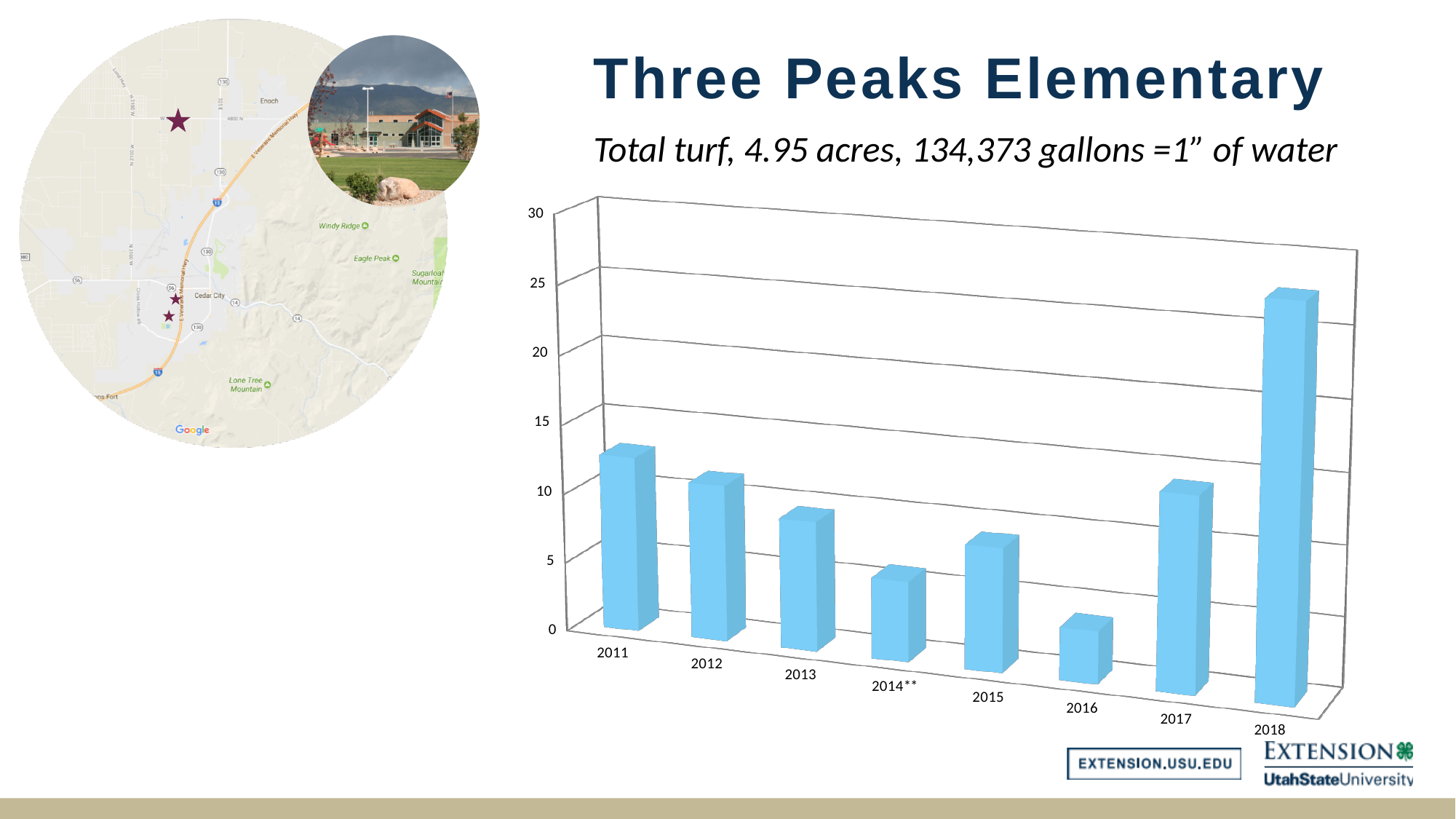
Is the value for 2011 greater or less than 10? greater Is the value for 2017 greater or less than 5? greater Which year has the lowest bar in the chart? 2016 Is the value for 2016 greater or less than 5? less Do the values rise or fall from 2011 to 2014**? fall Which year has the highest bar in the chart? 2018 What kind of chart is shown on the slide? bar chart How many years are shown on the x axis of the chart? 8 What is the highest value shown on the vertical axis of the chart? 30 Which is larger, the value for 2015 or the value for 2016? 2015 Which is larger, the value for 2011 or the value for 2012? 2011